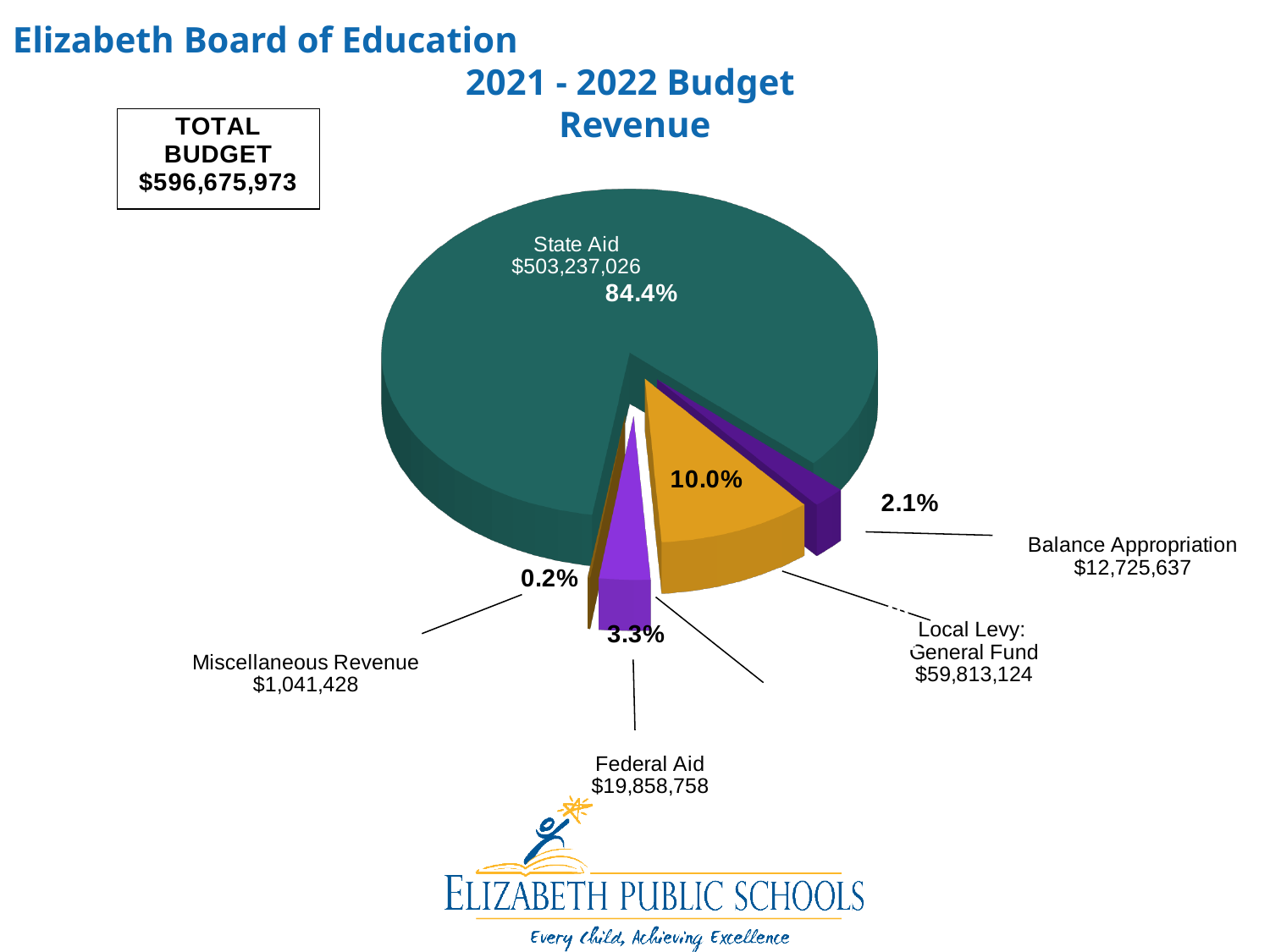
What share of the pie does State Aid represent? 84.4% What is the revenue amount for Balance Appropriation? $12,725,637 What is the revenue amount for State Aid? $503,237,026 Which is larger, Federal Aid or Balance Appropriation? Federal Aid Which revenue category is the largest? State Aid What is the revenue amount for Federal Aid? $19,858,758 What is the revenue amount for Miscellaneous Revenue? $1,041,428 Which revenue category is the smallest? Miscellaneous Revenue What share of the pie does Federal Aid represent? 3.3% What type of chart is shown on the slide? Pie chart How many revenue categories are shown in the pie chart? 5 What is the revenue amount for Local Levy: General Fund? $59,813,124